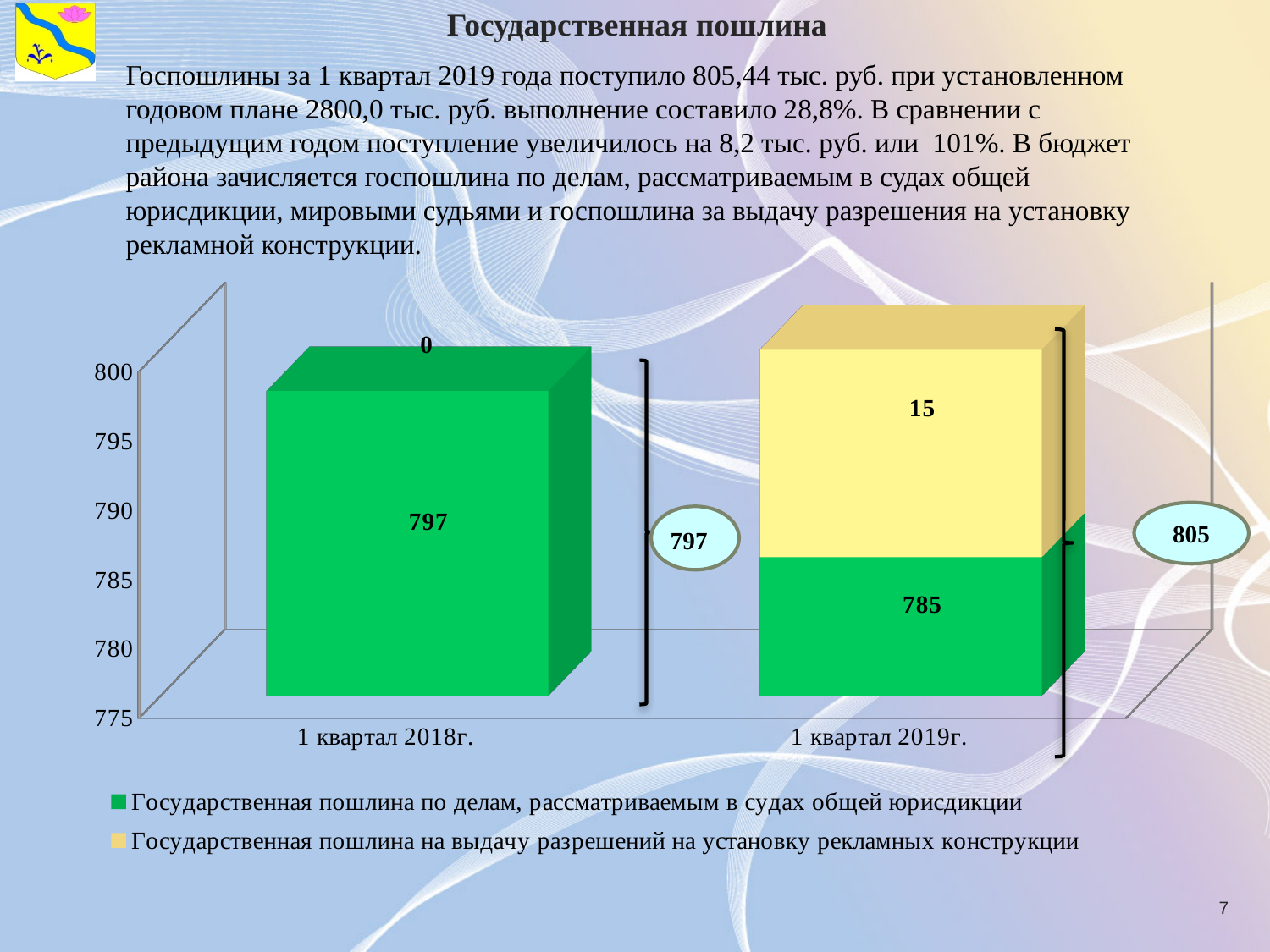
What is the value of 'Государственная пошлина на выдачу разрешений на установку рекламных конструкции' for 1 квартал 2019г.? 15 What is the total of the stacked bar for 1 квартал 2018г.? 797 What is the value of 'Государственная пошлина на выдачу разрешений на установку рекламных конструкции' for 1 квартал 2018г.? 0 What is the value of 'Государственная пошлина по делам, рассматриваемым в судах общей юрисдикции' for 1 квартал 2019г.? 785 What colour represents 'Государственная пошлина на выдачу разрешений на установку рекламных конструкции' in the chart? yellow What is the difference between the green series values for 1 квартал 2018г. and 1 квартал 2019г.? 12 What is the value of 'Государственная пошлина по делам, рассматриваемым в судах общей юрисдикции' for 1 квартал 2018г.? 797 Which period has the larger value for 'Государственная пошлина по делам, рассматриваемым в судах общей юрисдикции': 1 квартал 2018г. or 1 квартал 2019г.? 1 квартал 2018г. What total value is shown in the oval label next to the 1 квартал 2019г. bar? 805 What type of chart is shown on the slide? bar chart How many categories are shown on the x axis? 2 How many series does the legend list? 2